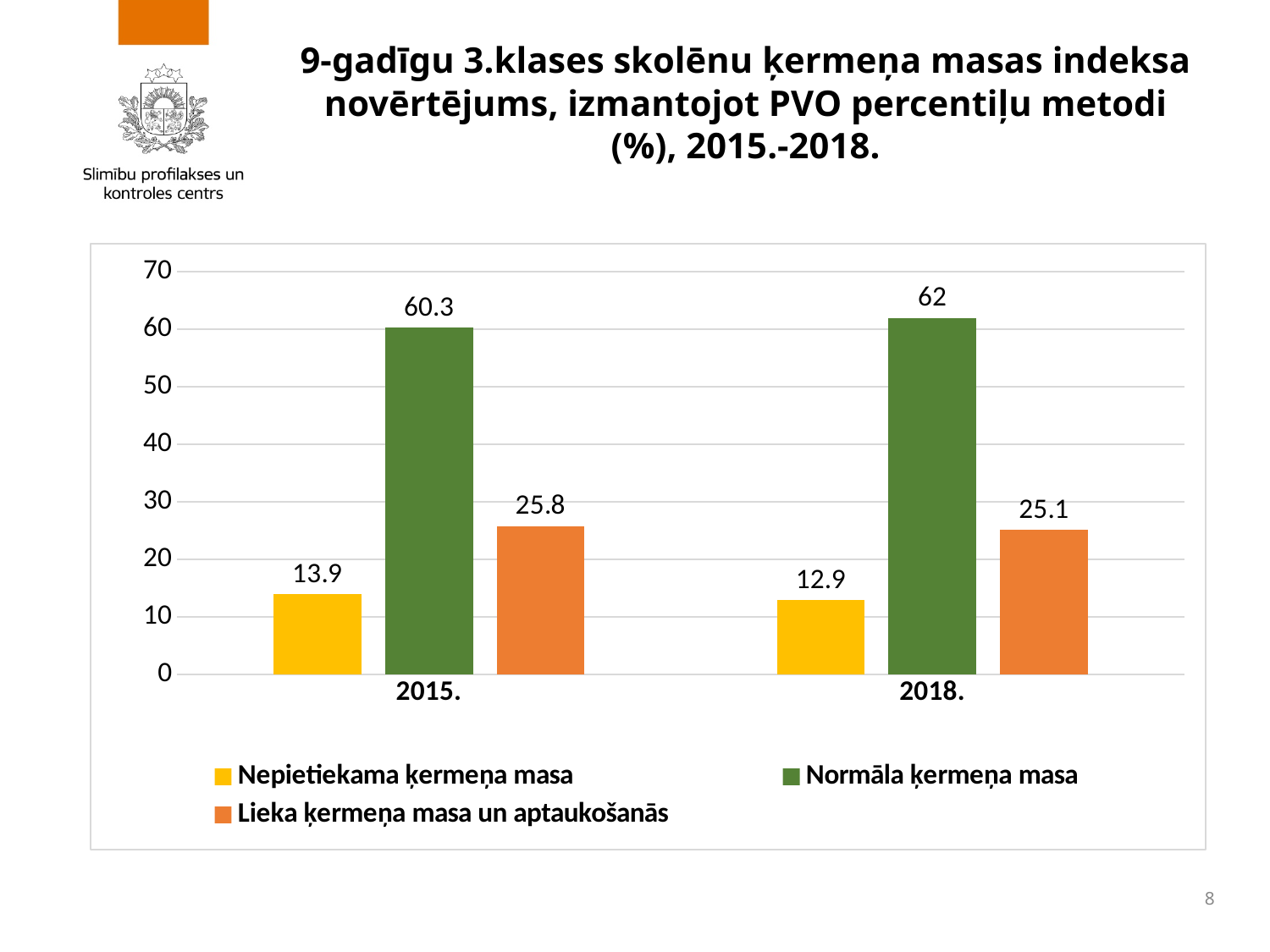
How many series does the legend list? 3 Which series has the lowest value in 2015.? Nepietiekama ķermeņa masa How many year categories are shown on the x axis? 2 What kind of chart is shown on the slide? bar chart What is the value for Nepietiekama ķermeņa masa in 2018.? 12.9 What is the difference between the Normāla ķermeņa masa values for 2018. and 2015.? 1.7 Is the value for Normāla ķermeņa masa in 2018. greater or less than 60? greater What is the value for Lieka ķermeņa masa un aptaukošanās in 2015.? 25.8 Which is larger: Lieka ķermeņa masa un aptaukošanās in 2015. or in 2018.? 2015. Which series has the highest value in 2018.? Normāla ķermeņa masa What colour are the bars for Nepietiekama ķermeņa masa? yellow What is the value for Normāla ķermeņa masa in 2015.? 60.3